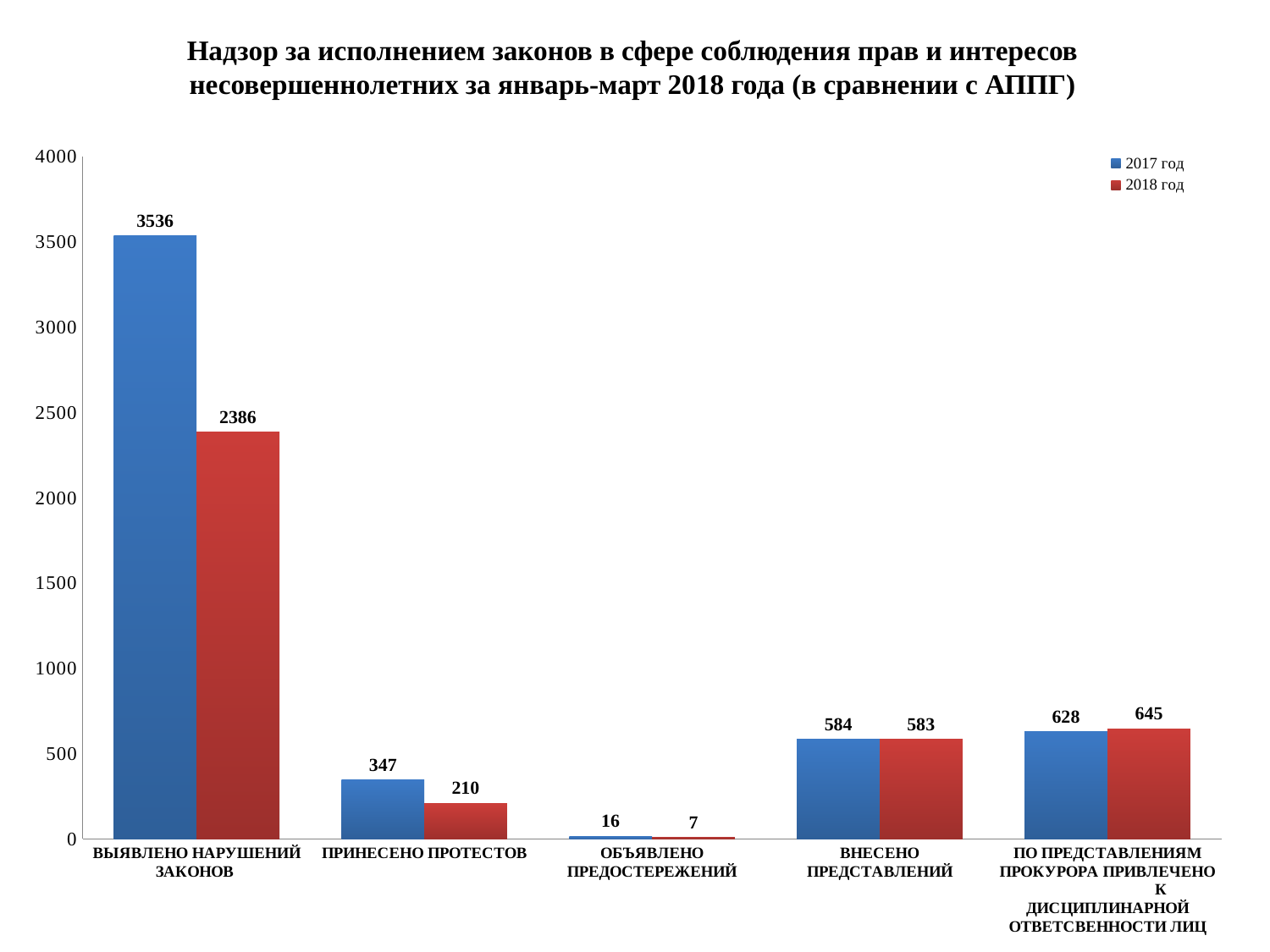
How many categories are shown on the x axis? 5 What is the difference between the 2018 год and 2017 год values for ПО ПРЕДСТАВЛЕНИЯМ ПРОКУРОРА ПРИВЛЕЧЕНО К ДИСЦИПЛИНАРНОЙ ОТВЕТСВЕННОСТИ ЛИЦ? 17 What is the difference between the 2017 год and 2018 год values for ВЫЯВЛЕНО НАРУШЕНИЙ ЗАКОНОВ? 1150 How many series does the legend list? 2 Which category has the highest value for 2018 год? ВЫЯВЛЕНО НАРУШЕНИЙ ЗАКОНОВ Is the 2018 год value for ВНЕСЕНО ПРЕДСТАВЛЕНИЙ greater or less than 500? greater What kind of chart is shown on the slide? bar chart What is the value for 2018 год in the category ОБЪЯВЛЕНО ПРЕДОСТЕРЕЖЕНИЙ? 7 What is the value for 2018 год in the category ПРИНЕСЕНО ПРОТЕСТОВ? 210 Which category has the lowest value for 2017 год? ОБЪЯВЛЕНО ПРЕДОСТЕРЕЖЕНИЙ What is the value for 2017 год in the category ВЫЯВЛЕНО НАРУШЕНИЙ ЗАКОНОВ? 3536 For ПРИНЕСЕНО ПРОТЕСТОВ, which year has the larger value, 2017 год or 2018 год? 2017 год